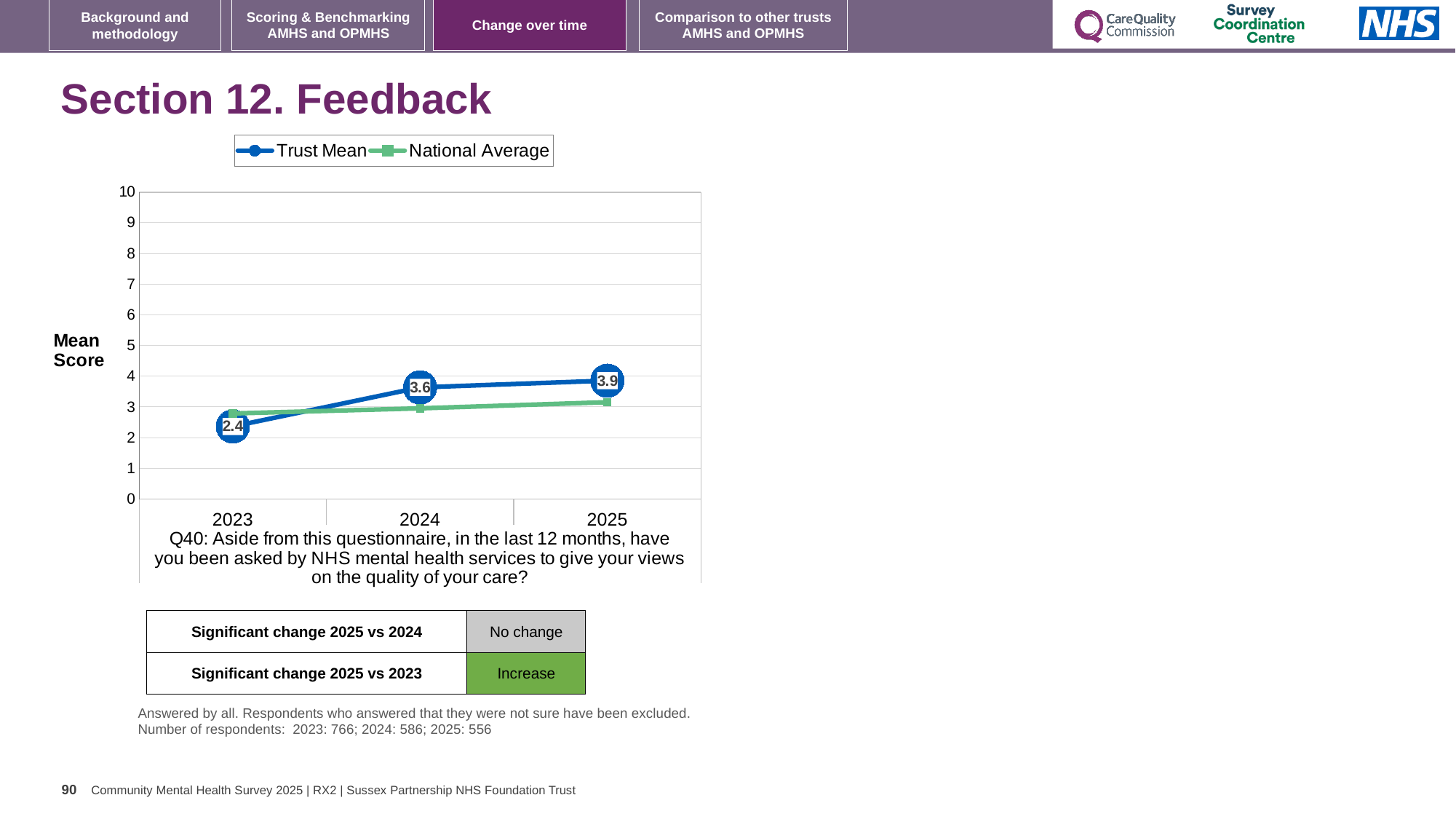
In 2023, which is larger, the Trust Mean or the National Average? National Average In which year is the Trust Mean score highest? 2025 What is the Trust Mean score for 2024? 3.6 What is the Trust Mean score for 2023? 2.4 What is the difference between the Trust Mean scores for 2024 and 2023? 1.2 In which year is the Trust Mean score lowest? 2023 Is the National Average value for 2025 greater or less than 4? less How many series does the chart legend list? 2 What kind of chart is shown on the slide? Line chart By how much did the Trust Mean score increase from 2023 to 2025? 1.5 How many years are plotted on the x axis of the chart? 3 What is the Trust Mean score for 2025? 3.9